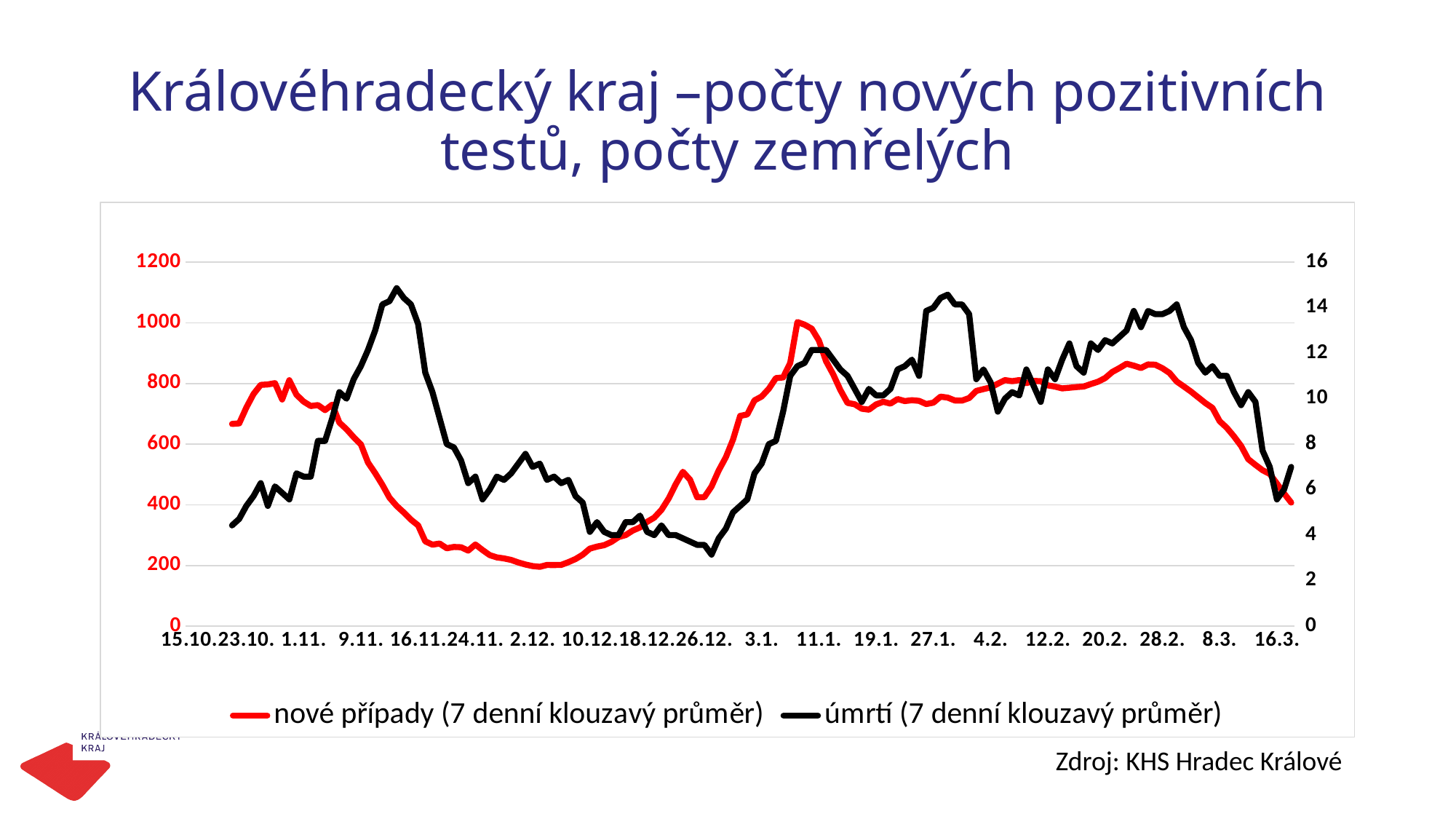
How many series does the legend list? 2 Is the value of the black line (úmrtí) at its peak around 16.11. greater or less than 12 on the right axis? greater Does the red line (nové případy) rise or fall between 10.12. and 11.1.? rise Does the red line (nové případy) rise or fall between 1.11. and 2.12.? fall Which series is drawn in red according to the legend? nové případy (7 denní klouzavý průměr) What is the highest value shown on the left vertical axis? 1200 What kind of chart is shown on the slide? line chart Is the value of the red line (nové případy) at 16.11. greater or less than 400? less Is the value of the red line (nové případy) at 2.12. greater or less than 400? less Does the black line (úmrtí) rise or fall between 16.11. and 26.12.? fall